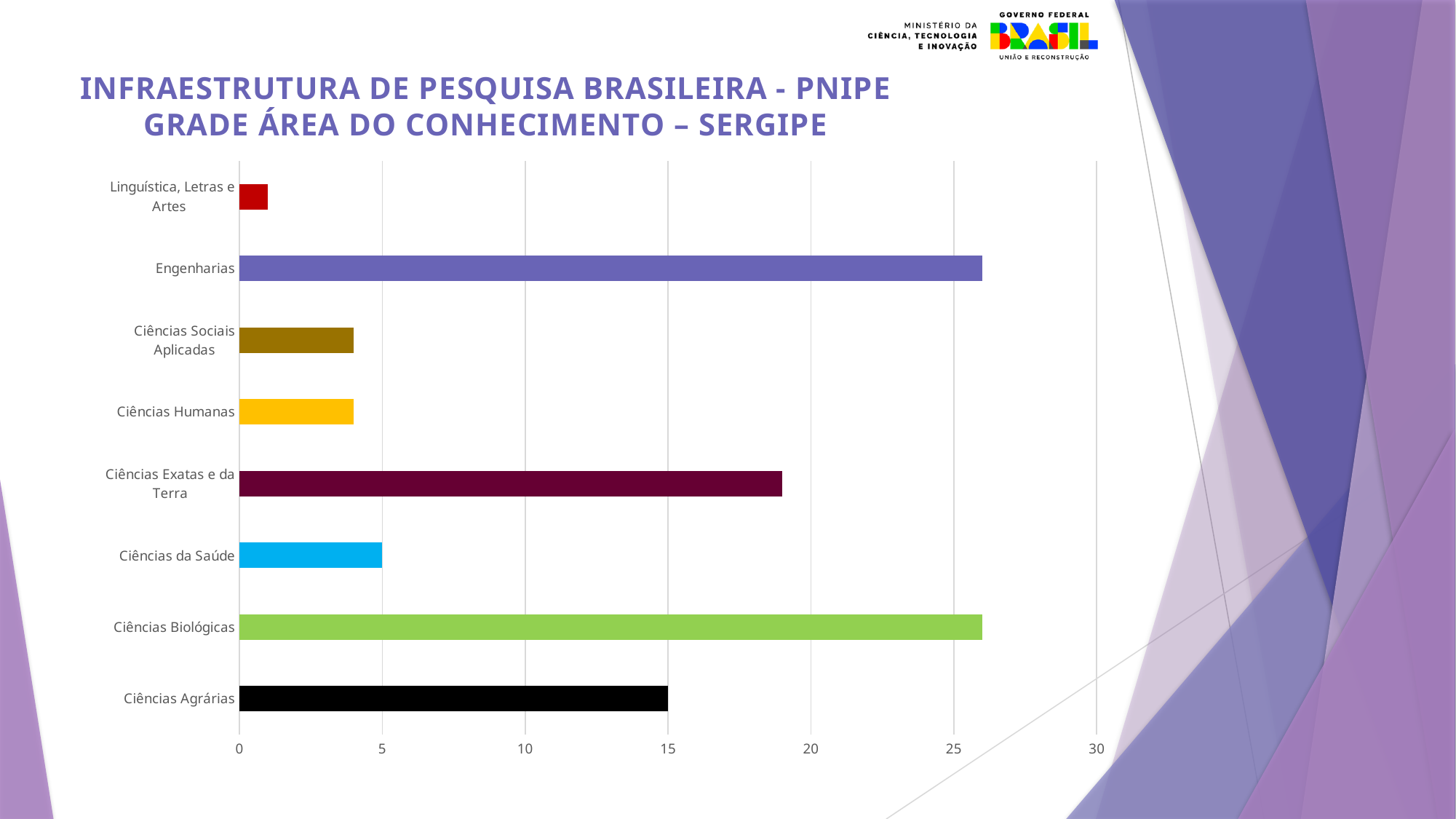
Which is larger, the value for Ciências Exatas e da Terra or the value for Ciências Agrárias? Ciências Exatas e da Terra What is the value for Ciências Agrárias? 15 How many knowledge areas (categories) are plotted in the chart? 8 Is the value for Ciências Humanas greater or less than 5? less What is the value for Ciências da Saúde? 5 Is the value for Engenharias greater or less than 25? greater Which Brazilian state does the chart title refer to? Sergipe What kind of chart is shown on the slide? bar chart Is the value for Ciências Biológicas greater or less than 25? greater What is the difference between the values for Ciências Agrárias and Ciências da Saúde? 10 Which category has the lowest value? Linguística, Letras e Artes